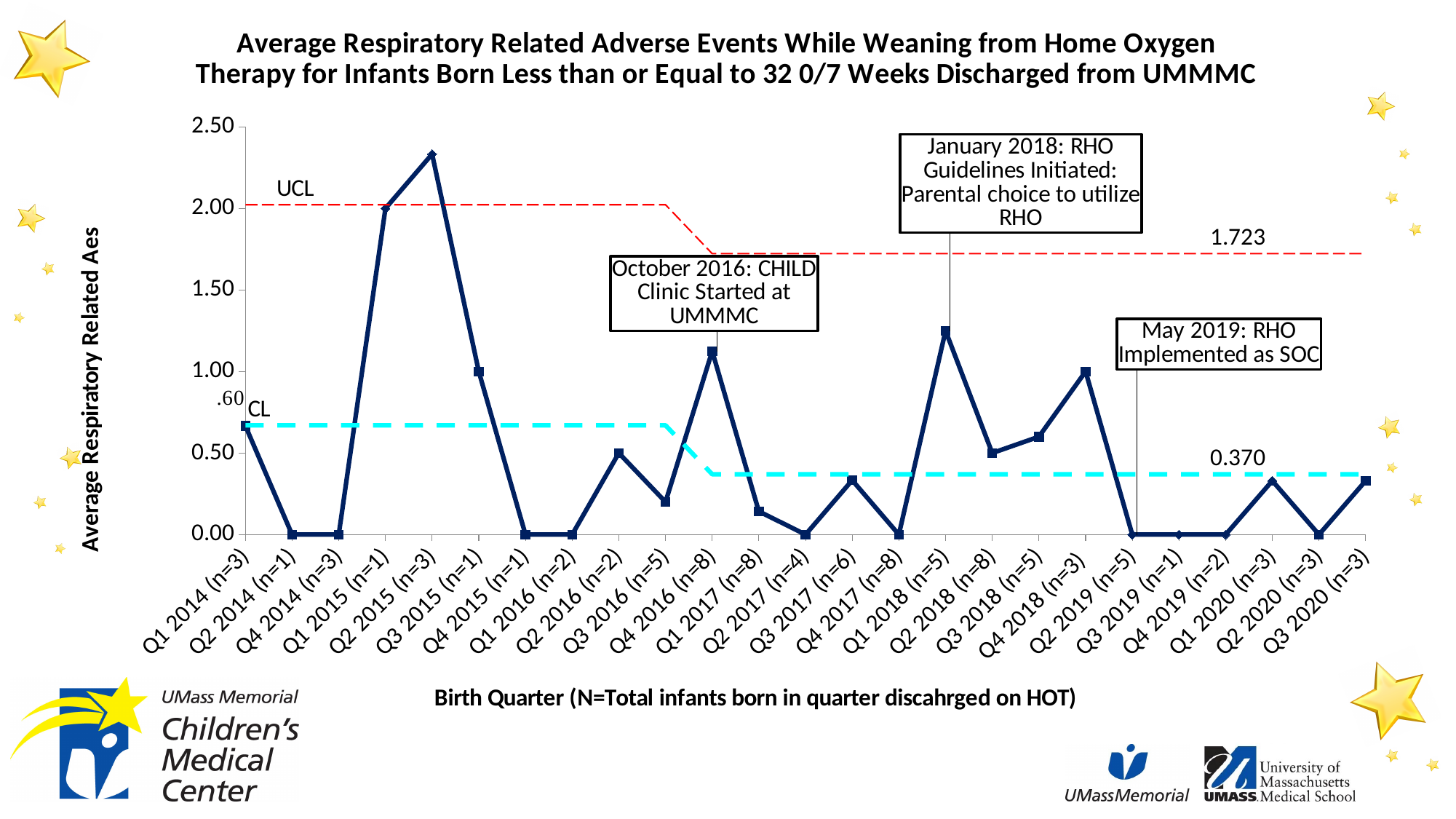
How many birth quarters are plotted along the x axis? 25 What is the difference between the values for Q3 2015 (n=1) and Q2 2016 (n=2)? 0.50 What is the average respiratory related adverse events value for Q4 2018 (n=3)? 1.00 What is the average respiratory related adverse events value for Q3 2015 (n=1)? 1.00 Which is larger, the value for Q1 2018 (n=5) or the value for Q4 2018 (n=3)? Q1 2018 (n=5) Which birth quarter has the highest average respiratory related adverse events? Q2 2015 (n=3) What value is labelled on the CL line in the later part of the chart? 0.370 Is the value for Q3 2018 (n=5) greater or less than 1.00? less What is the average respiratory related adverse events value for Q2 2016 (n=2)? 0.50 What kind of chart is shown on the slide? line chart What value is labelled on the UCL line in the later part of the chart? 1.723 Is the value for Q2 2015 (n=3) greater or less than 2.00? greater